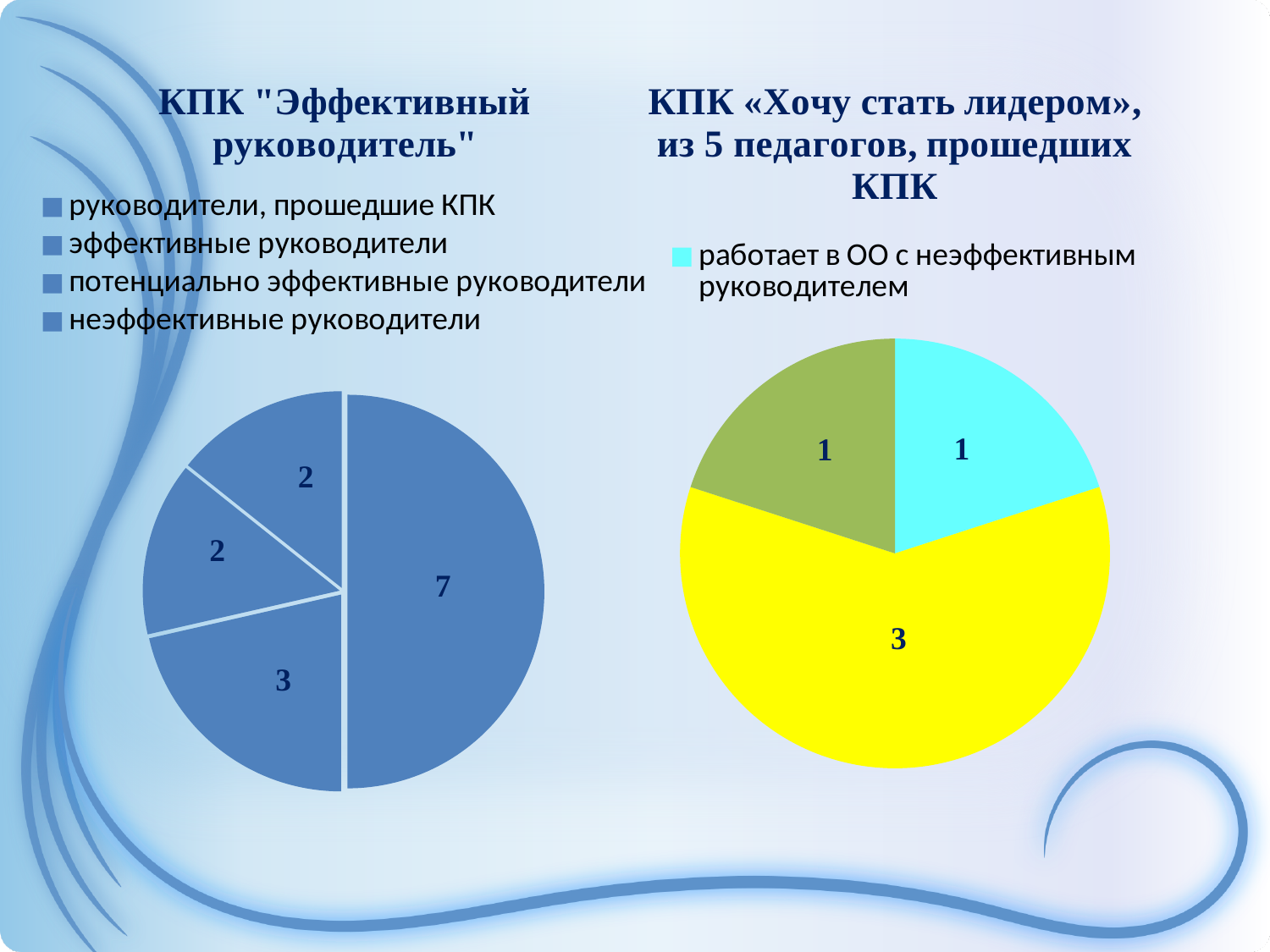
In the chart titled КПК "Эффективный руководитель", what is the total of all slice values? 14 In the chart titled КПК "Эффективный руководитель", what is the value of the largest slice? 7 How many entries does the legend of the chart titled КПК "Эффективный руководитель" list? 4 How many slices does the chart titled КПК "Эффективный руководитель" have? 4 In the chart titled КПК «Хочу стать лидером», what share of the pie is the slice for работает в ОО с неэффективным руководителем? 20% In the chart titled КПК «Хочу стать лидером», what colour is the slice for работает в ОО с неэффективным руководителем? cyan In the chart titled КПК "Эффективный руководитель", what is the value of the smallest slice? 2 In the chart titled КПК «Хочу стать лидером», what is the value for работает в ОО с неэффективным руководителем? 1 What kind of chart is the chart titled КПК "Эффективный руководитель"? pie chart How many slices does the chart titled КПК «Хочу стать лидером» have? 3 In the chart titled КПК «Хочу стать лидером», what is the value of the largest slice? 3 In the chart titled КПК "Эффективный руководитель", what is the difference between the largest slice and the slice labelled 3? 4